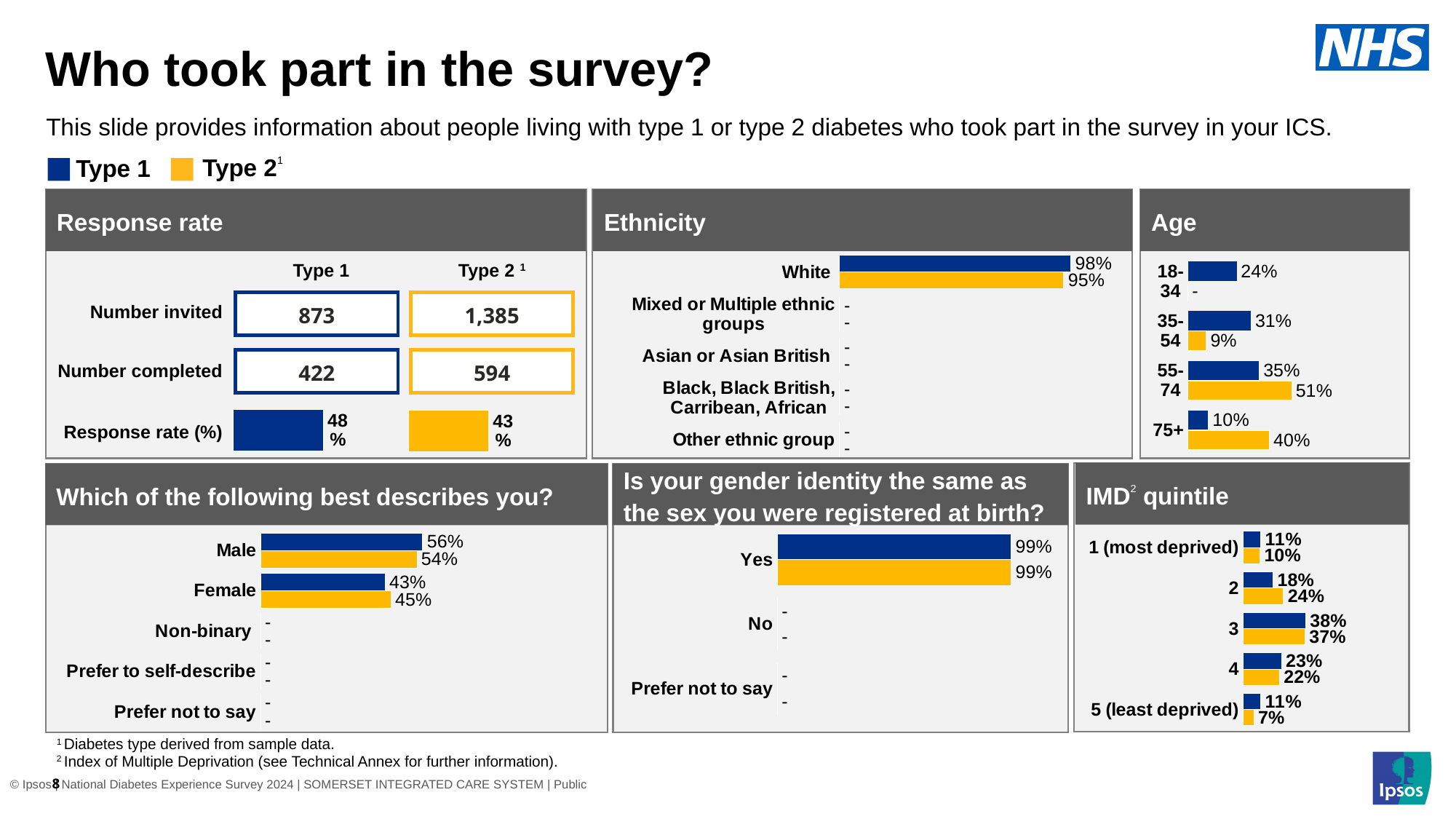
In the IMD quintile chart, which quintile has the highest Type 1 value? 3 In the Response rate chart, what is the number completed for Type 2? 594 In the Age chart, what is the Type 1 value for 75+? 10% In the Response rate chart, what is the number invited for Type 1? 873 In the 'Which of the following best describes you?' chart, what is the difference between the Type 1 values for Male and Female? 13 percentage points In the gender identity chart, what is the Type 1 value for Yes? 99% In the 'Which of the following best describes you?' chart, what is the Type 2 value for Female? 45% In the Age chart, which is larger for the 35-54 group, the Type 1 value or the Type 2 value? Type 1 In the Age chart, which age group has the highest Type 2 value? 55-74 In the Ethnicity chart, what is the Type 2 value for White? 95% In the Response rate chart, what is the difference between the Type 1 and Type 2 response rates? 5 percentage points How many series does the legend at the top of the slide list? 2